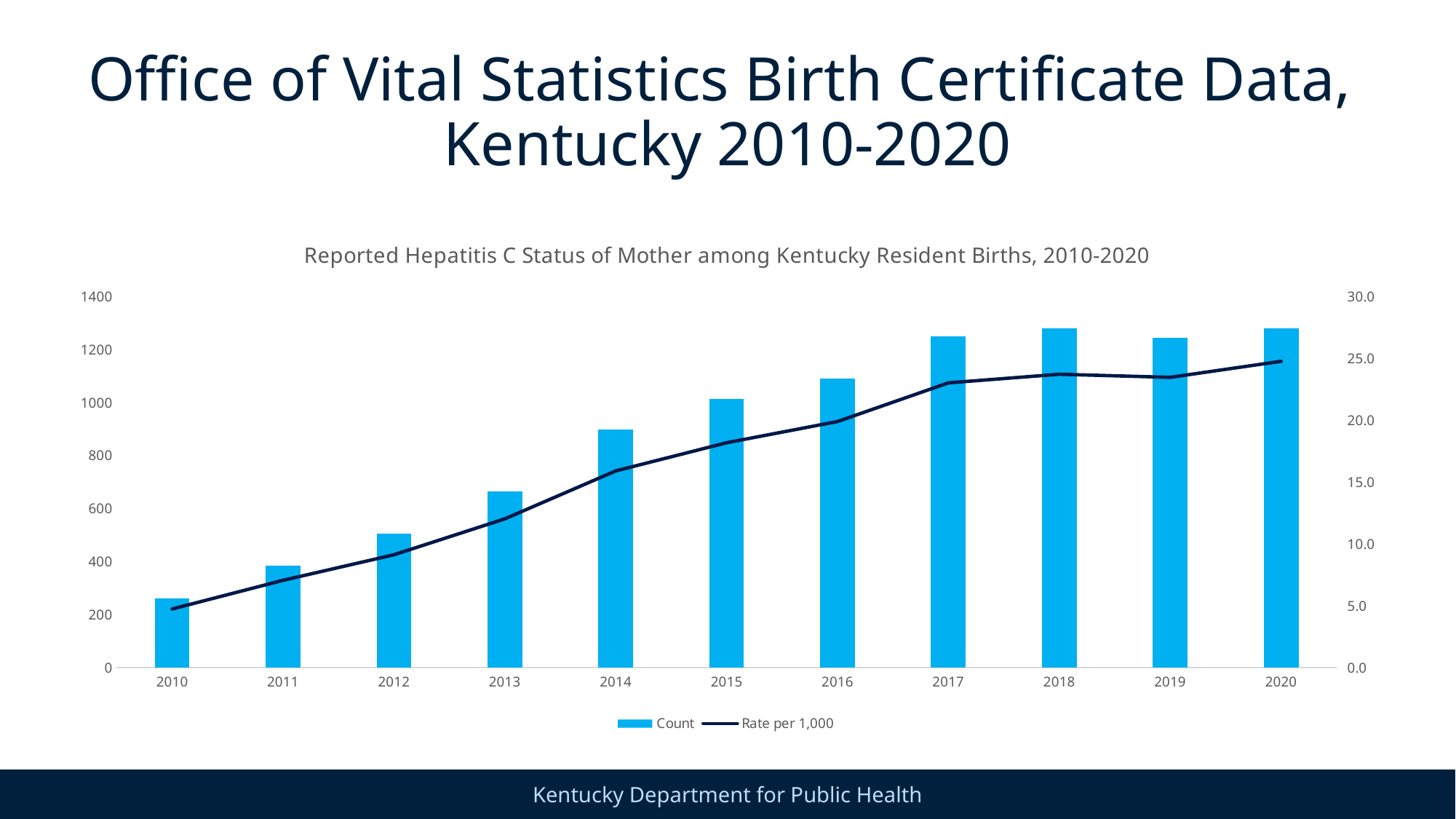
Is the Rate per 1,000 for 2020 greater or less than 20.0? greater Which year has the highest Rate per 1,000? 2020 Which year has a larger Count, 2013 or 2014? 2014 Is the Count for 2010 greater or less than 400? less What kind of chart is shown on the slide? A combination bar and line chart Is the Count for 2017 greater or less than 1200? greater Does the Rate per 1,000 generally rise or fall from 2010 to 2020? rise How many years are shown on the x axis? 11 Which year has the lowest Count? 2010 How many series does the legend list? 2